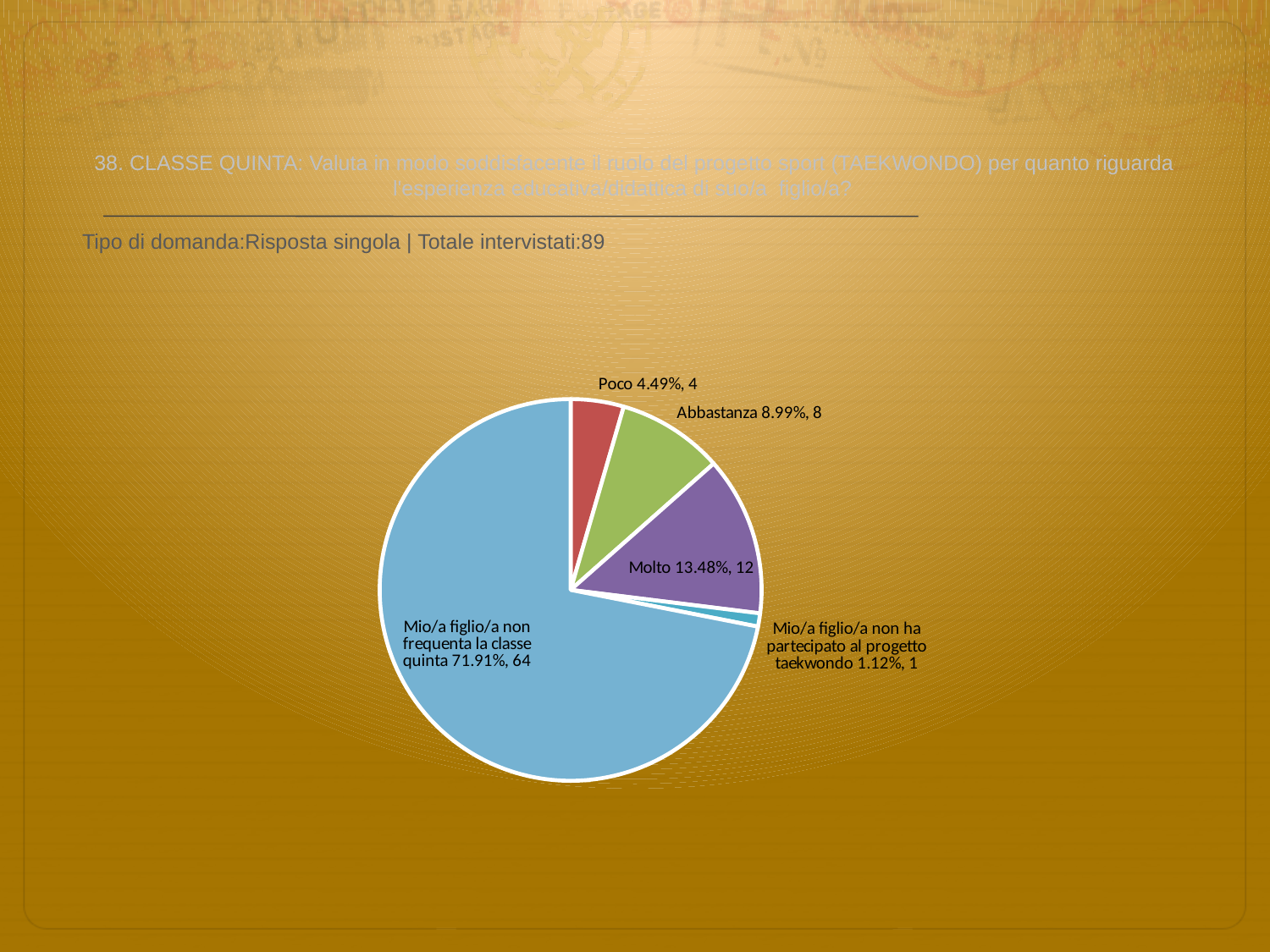
What colour is the 'Molto' slice? purple What kind of chart is shown on the slide? pie chart What is the percentage share of the 'Mio/a figlio/a non ha partecipato al progetto taekwondo' slice? 1.12% What percentage share does the 'Mio/a figlio/a non frequenta la classe quinta' slice have? 71.91% Which slice is the smallest in the pie chart? Mio/a figlio/a non ha partecipato al progetto taekwondo Which slice is the largest in the pie chart? Mio/a figlio/a non frequenta la classe quinta What is the count for the 'Poco' slice? 4 What percentage share does the 'Molto' slice have? 13.48% Which has a larger share, 'Poco' or 'Abbastanza'? Abbastanza How many respondents answered 'Abbastanza'? 8 How many slices does the pie chart have? 5 What is the difference in count between 'Molto' and 'Abbastanza'? 4